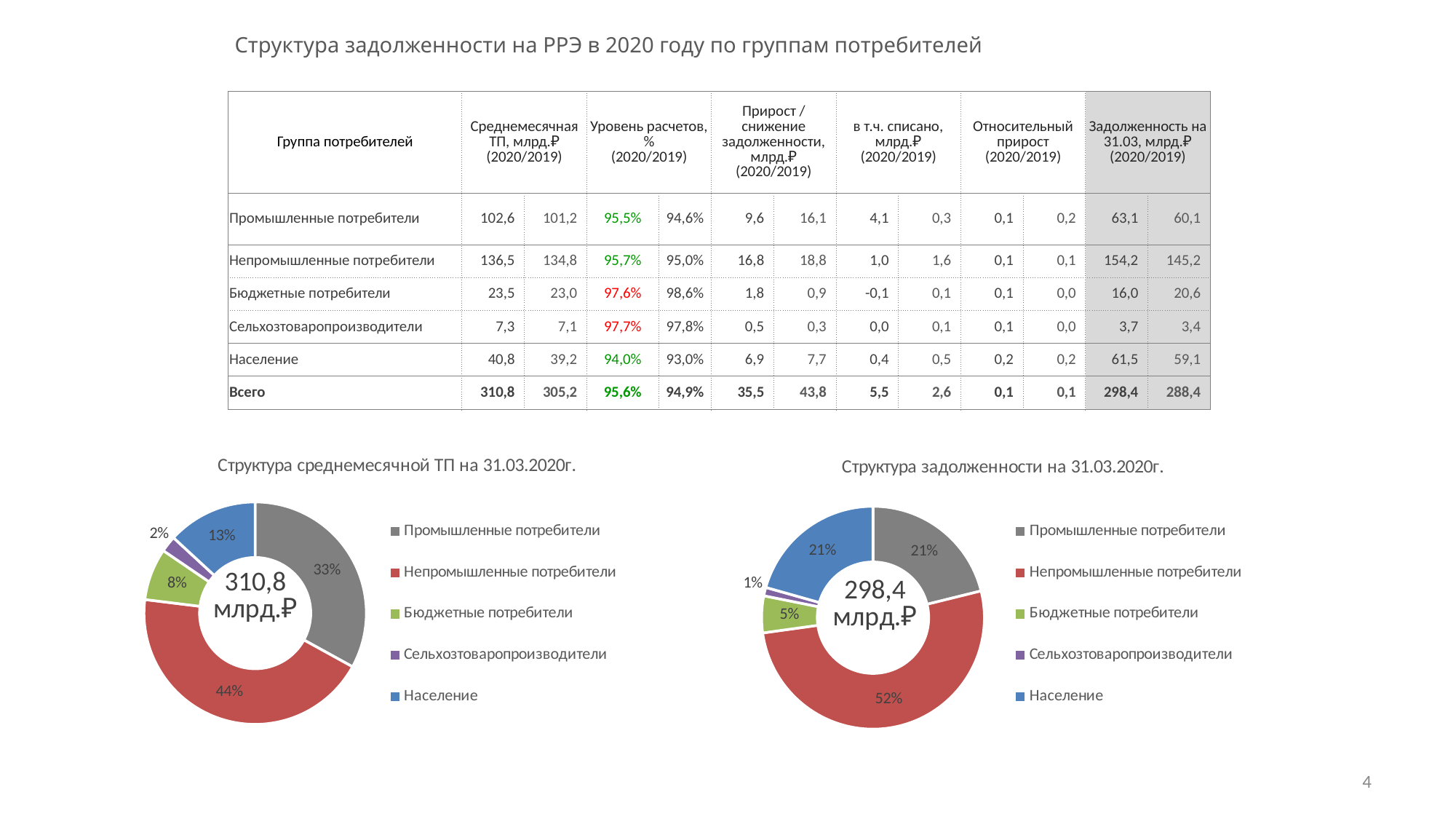
In the chart 'Структура среднемесячной ТП на 31.03.2020г.', which group has the smallest share? Сельхозтоваропроизводители In the chart 'Структура среднемесячной ТП на 31.03.2020г.', what share do Непромышленные потребители have? 44% How many categories does the legend of the chart 'Структура задолженности на 31.03.2020г.' list? 5 In the chart 'Структура среднемесячной ТП на 31.03.2020г.', what share do Промышленные потребители have? 33% In the chart 'Структура задолженности на 31.03.2020г.', what is the difference between the shares of Непромышленные потребители and Промышленные потребители? 31% In the chart 'Структура задолженности на 31.03.2020г.', what share do Непромышленные потребители have? 52% In the chart 'Структура задолженности на 31.03.2020г.', which group has the largest share? Непромышленные потребители In the chart 'Структура среднемесячной ТП на 31.03.2020г.', which is larger: the share of Бюджетные потребители or the share of Население? Население What type of chart is 'Структура среднемесячной ТП на 31.03.2020г.'? Doughnut chart In the chart 'Структура задолженности на 31.03.2020г.', what share do Бюджетные потребители have? 5% What total value is shown in the centre of the chart 'Структура задолженности на 31.03.2020г.'? 298,4 млрд.₽ In the chart 'Структура среднемесячной ТП на 31.03.2020г.', what share does Население have? 13%